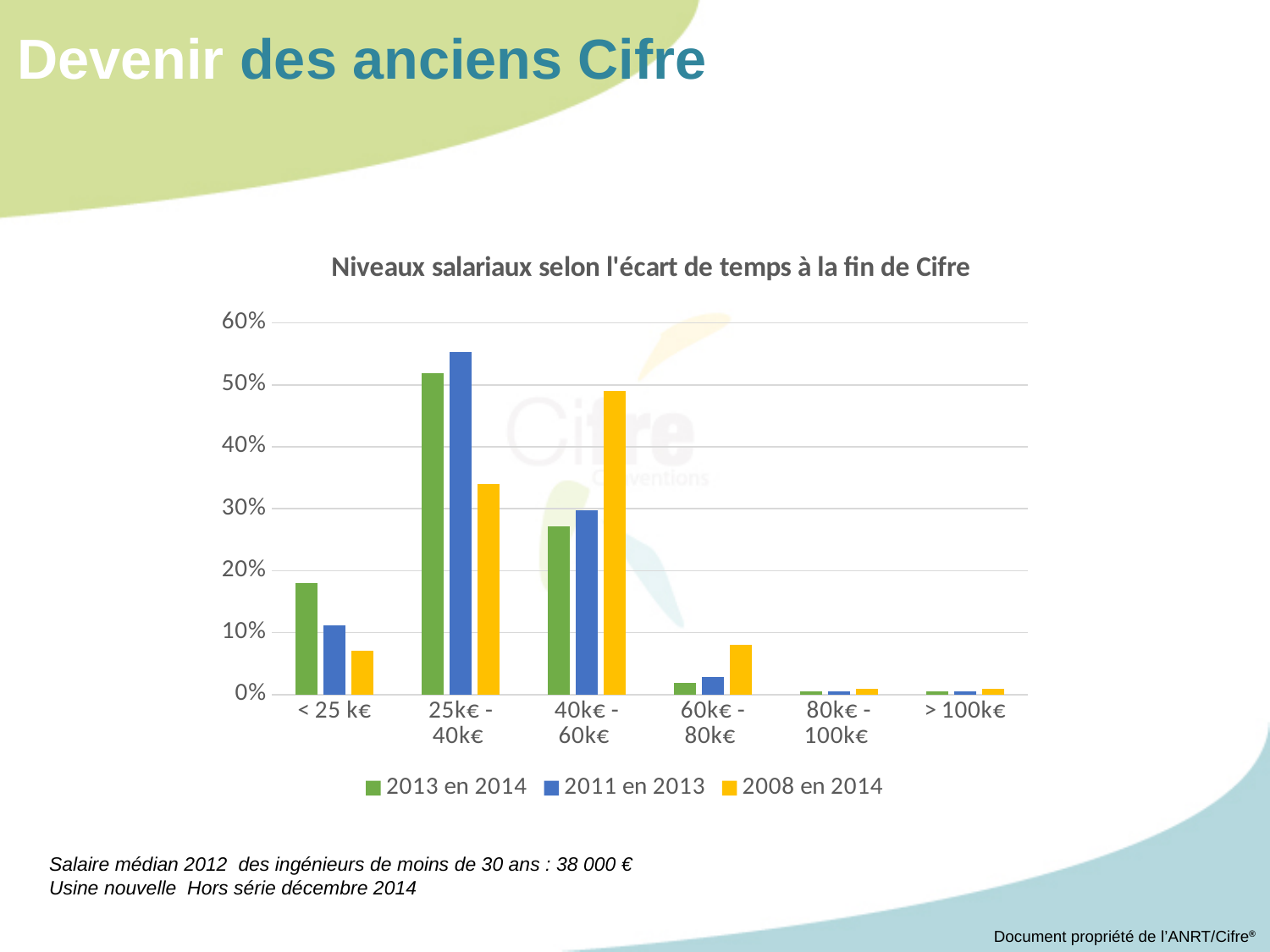
Is the value for 2013 en 2014 in the < 25 k€ category greater or less than 10%? greater Is the value for 2008 en 2014 in the 25k€ - 40k€ category greater or less than 40%? less Is the value for 2011 en 2013 in the 25k€ - 40k€ category greater or less than 50%? greater How many series does the legend list? 3 In the < 25 k€ category, which series has the larger value: 2013 en 2014 or 2008 en 2014? 2013 en 2014 For the series 2008 en 2014, which salary category has the highest value? 40k€ - 60k€ For the series 2013 en 2014, which salary category has the highest value? 25k€ - 40k€ How many salary categories are shown on the x axis? 6 What is the title of the chart? Niveaux salariaux selon l'écart de temps à la fin de Cifre In the 40k€ - 60k€ category, which series has the larger value: 2008 en 2014 or 2013 en 2014? 2008 en 2014 For the series 2011 en 2013, which salary category has the highest value? 25k€ - 40k€ What kind of chart is shown on the slide? Bar chart